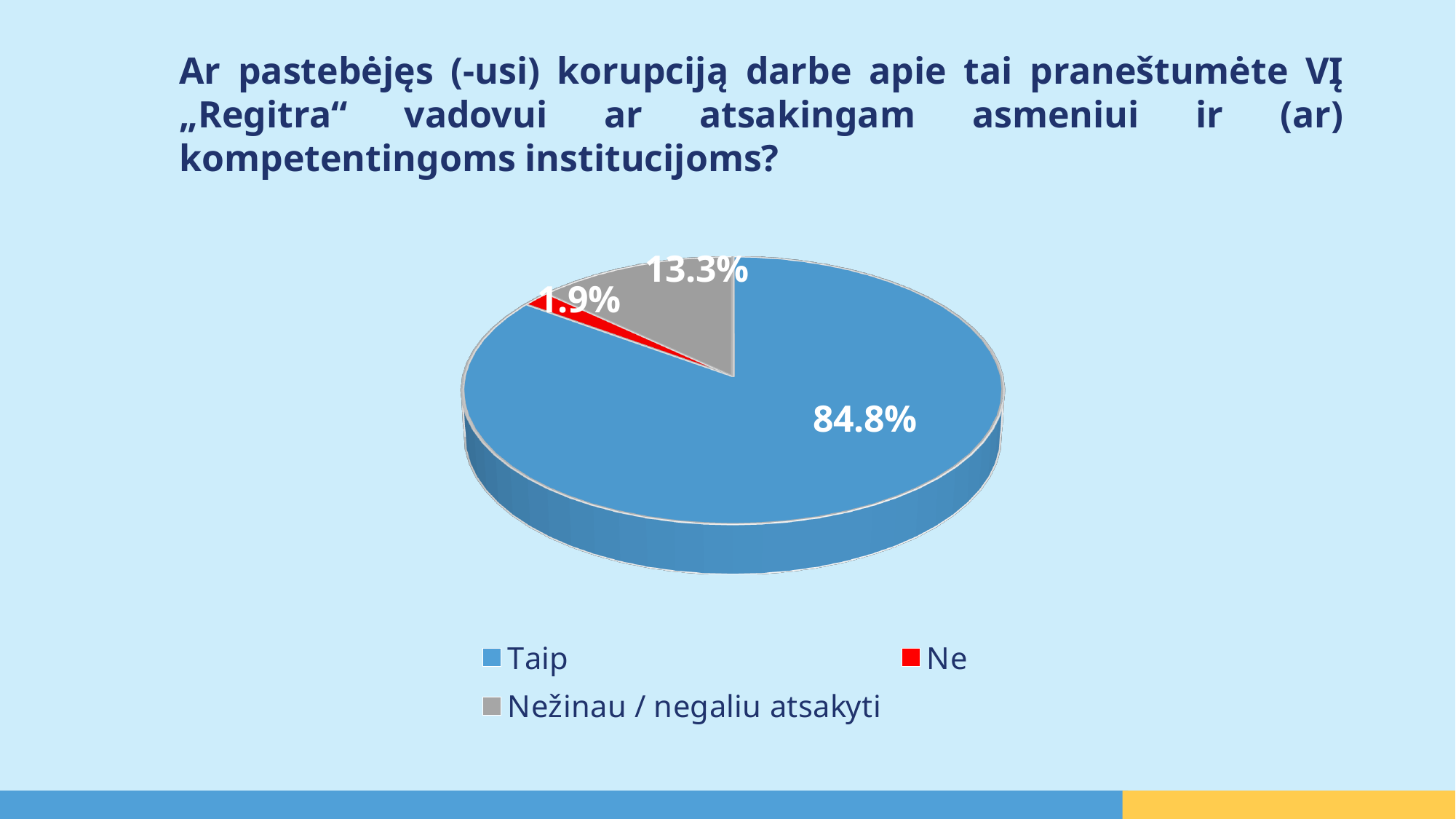
What colour is the slice for "Taip"? blue Which is larger, the share for "Ne" or the share for "Nežinau / negaliu atsakyti"? Nežinau / negaliu atsakyti What kind of chart is shown on the slide? pie chart Which answer has the smallest slice of the pie? Ne What share of respondents answered "Taip"? 84.8% What colour is the slice for "Ne"? red Which answer has the largest slice of the pie? Taip What is the difference in percentage points between "Taip" and "Nežinau / negaliu atsakyti"? 71.5 What share of respondents answered "Nežinau / negaliu atsakyti"? 13.3% How many slices does the pie chart have? 3 What share of respondents answered "Ne"? 1.9% How many entries does the legend list? 3